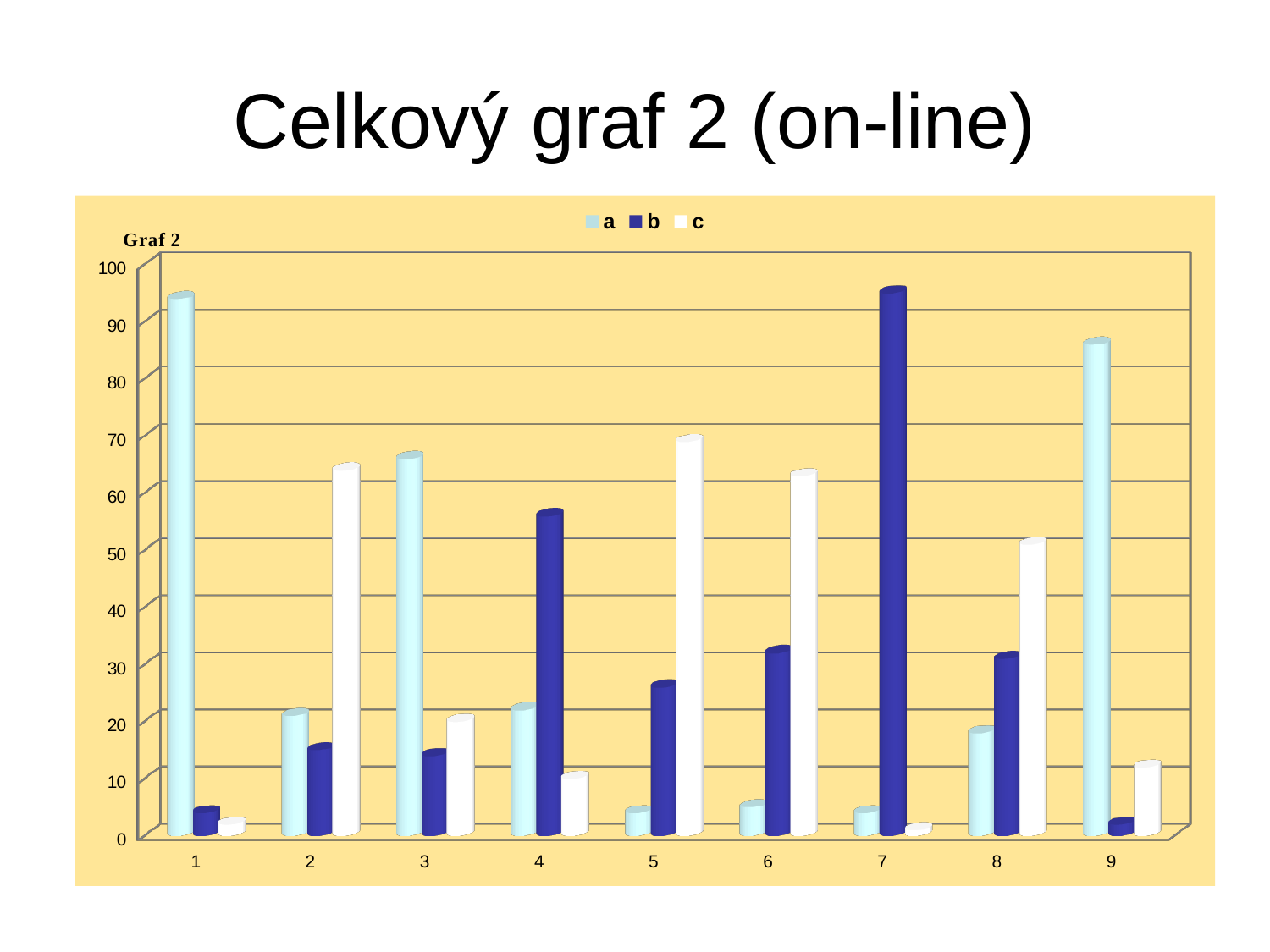
At category 4, which series has the larger value, a or b? b What are the entries listed in the legend? a, b, c What kind of chart is shown on the slide? bar chart How many categories are shown on the x axis? 9 Is the value for series c at category 2 greater or less than 60? greater Which category has the highest value for series b? 7 How many series does the legend list? 3 Is the value for series a at category 9 greater or less than 80? greater Is the value for series b at category 7 greater or less than 90? greater Which category has the highest value for series a? 1